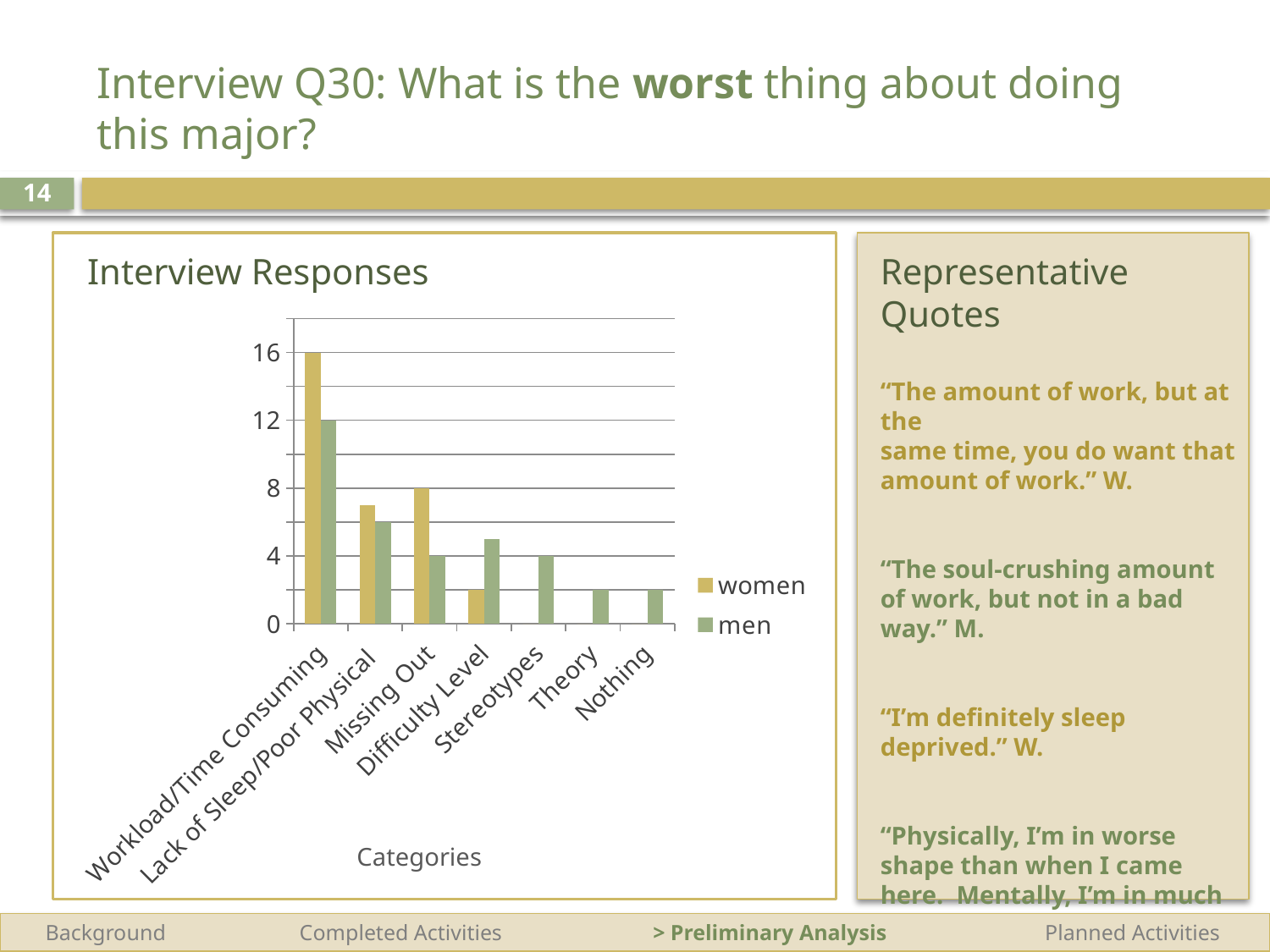
What is the difference between the women and men values in the Workload/Time Consuming category? 4 What is the value for men in the Missing Out category? 4 What is the value for women in the Workload/Time Consuming category? 16 What is the value for women in the Missing Out category? 8 Is the value for women in the Lack of Sleep/Poor Physical category greater or less than 8? less How many categories are shown on the x axis of the Interview Responses chart? 7 What kind of chart is shown under the title "Interview Responses"? bar chart In the Difficulty Level category, which series has the larger value, women or men? men What is the value for men in the Workload/Time Consuming category? 12 Which category has the highest value for women? Workload/Time Consuming What is the title of the x axis on the Interview Responses chart? Categories How many series does the legend of the Interview Responses chart list? 2